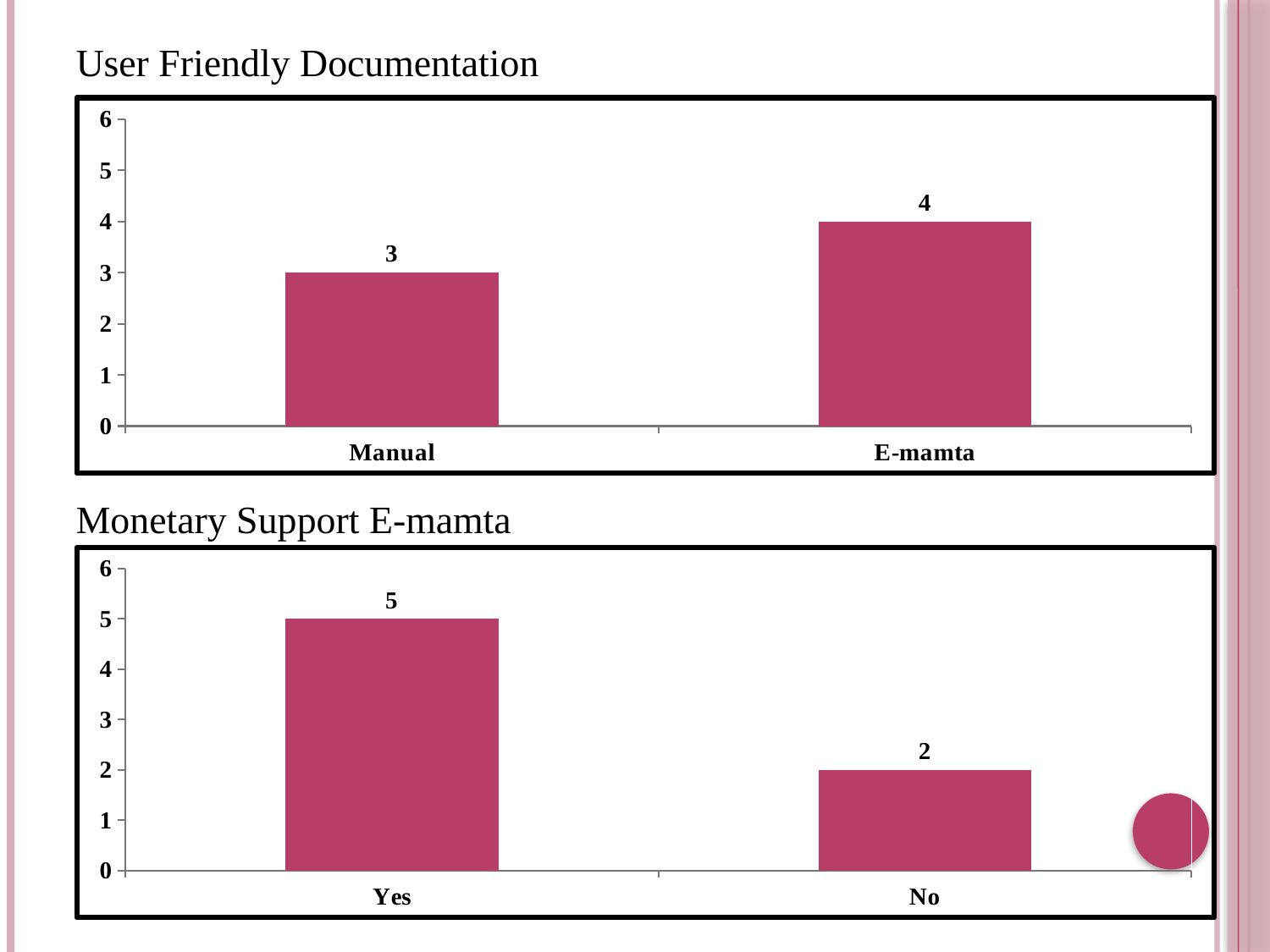
In the 'Monetary Support E-mamta' chart, what is the value for No? 2 What kind of chart is the 'User Friendly Documentation' chart? Bar chart In the 'User Friendly Documentation' chart, what is the value for E-mamta? 4 In the 'User Friendly Documentation' chart, what is the difference between the values for E-mamta and Manual? 1 In the 'Monetary Support E-mamta' chart, what is the value for Yes? 5 In the 'Monetary Support E-mamta' chart, which is larger, the value for Yes or the value for No? Yes In the 'Monetary Support E-mamta' chart, what is the difference between the values for Yes and No? 3 In the 'User Friendly Documentation' chart, what is the value for Manual? 3 In the 'User Friendly Documentation' chart, which category has the highest value? E-mamta In the 'User Friendly Documentation' chart, how many categories are shown? 2 In the 'Monetary Support E-mamta' chart, which category has the lowest value? No In the 'Monetary Support E-mamta' chart, is the value for Yes greater or less than 4? greater